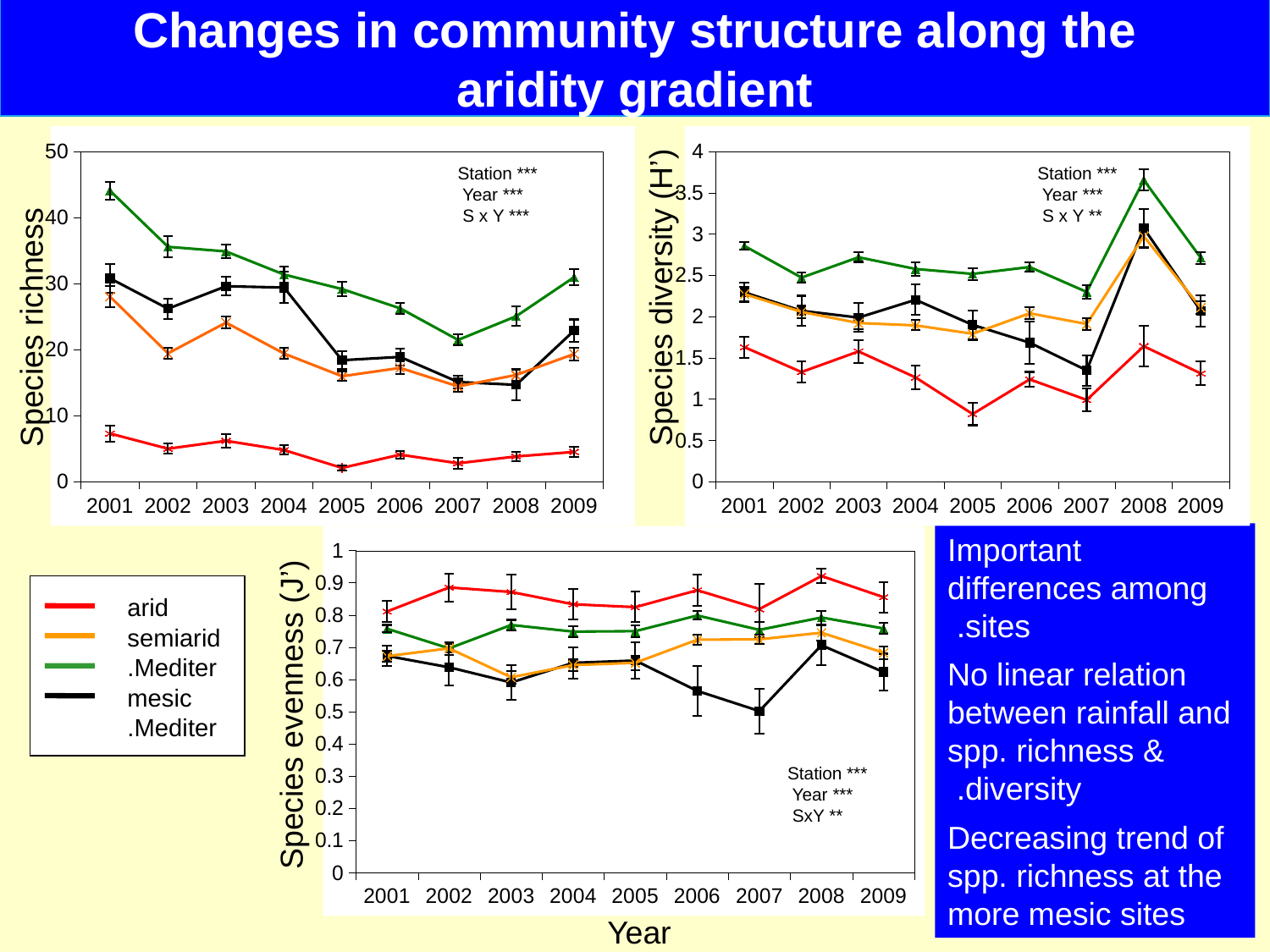
In the Species evenness (J') chart, is the value for mesic Mediter in 2007 greater or less than 0.6? less What kind of chart is the Species richness chart? line chart In the Species richness chart, which series has the highest value in 2001? Mediter In the Species diversity (H') chart, is the value for arid in 2005 greater or less than 1? less In the Species evenness (J') chart, which series has the highest value in 2008? arid In the Species richness chart, is the value for arid in 2001 greater or less than 10? less In the Species richness chart, does the Mediter series rise or fall from 2001 to 2007? fall How many years are plotted along the x axis of the Species richness chart? 9 In the Species evenness (J') chart, which is larger in 2002: arid or mesic Mediter? arid How many series does the legend list? 4